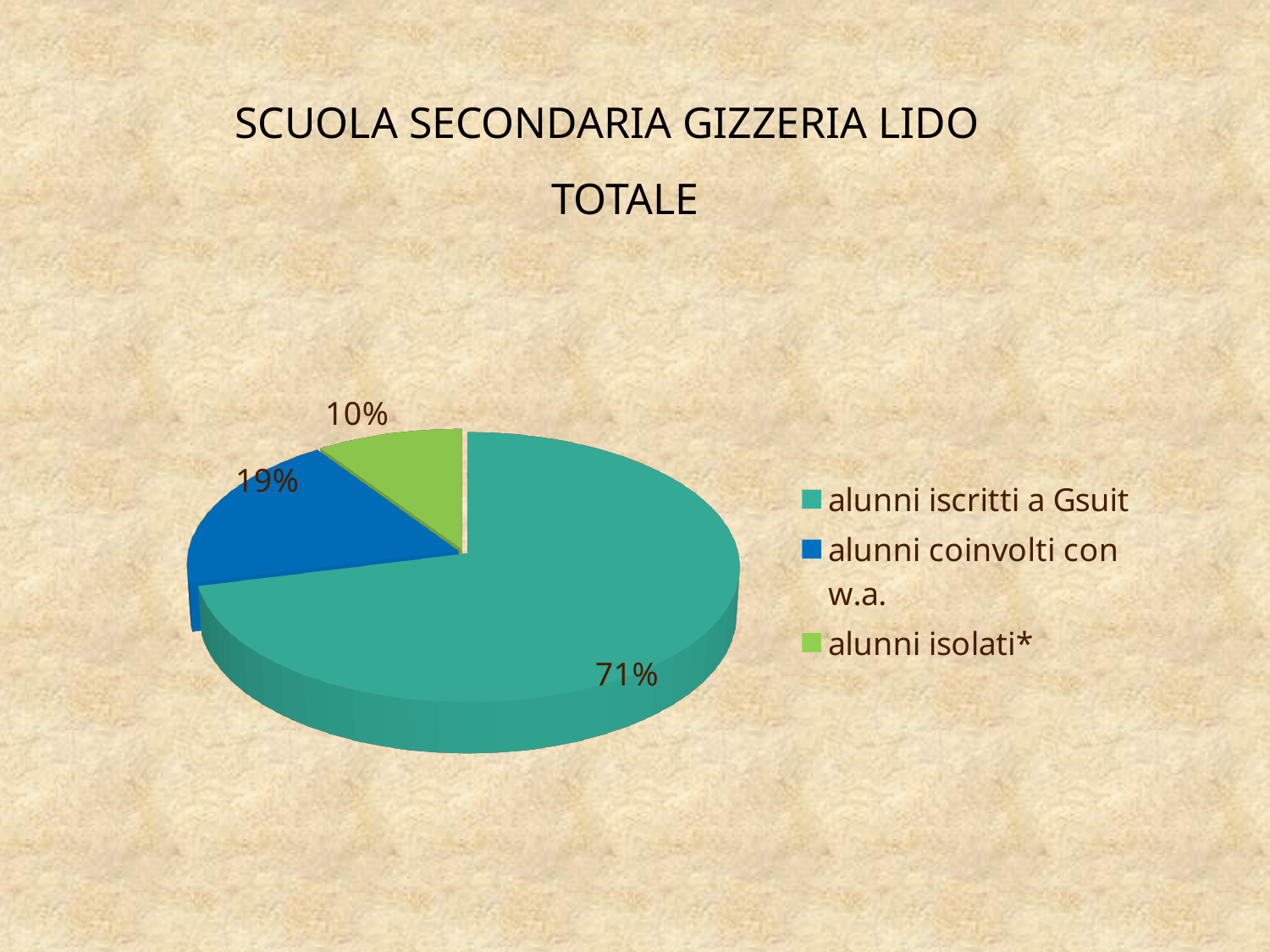
What is the difference in percentage points between 'alunni iscritti a Gsuit' and 'alunni coinvolti con w.a.'? 52 Which is larger, the slice for 'alunni coinvolti con w.a.' or the slice for 'alunni isolati*'? alunni coinvolti con w.a. What percentage of the pie is 'alunni iscritti a Gsuit'? 71% What percentage of the pie is 'alunni coinvolti con w.a.'? 19% How many categories does the pie chart have? 3 What percentage of the pie is 'alunni isolati*'? 10% Which category has the largest slice of the pie? alunni iscritti a Gsuit Which category has the smallest slice of the pie? alunni isolati* What kind of chart is shown on the slide? pie chart What is the title of the chart? SCUOLA SECONDARIA GIZZERIA LIDO TOTALE What is the difference in percentage points between 'alunni coinvolti con w.a.' and 'alunni isolati*'? 9 What colour is the slice for 'alunni isolati*'? green